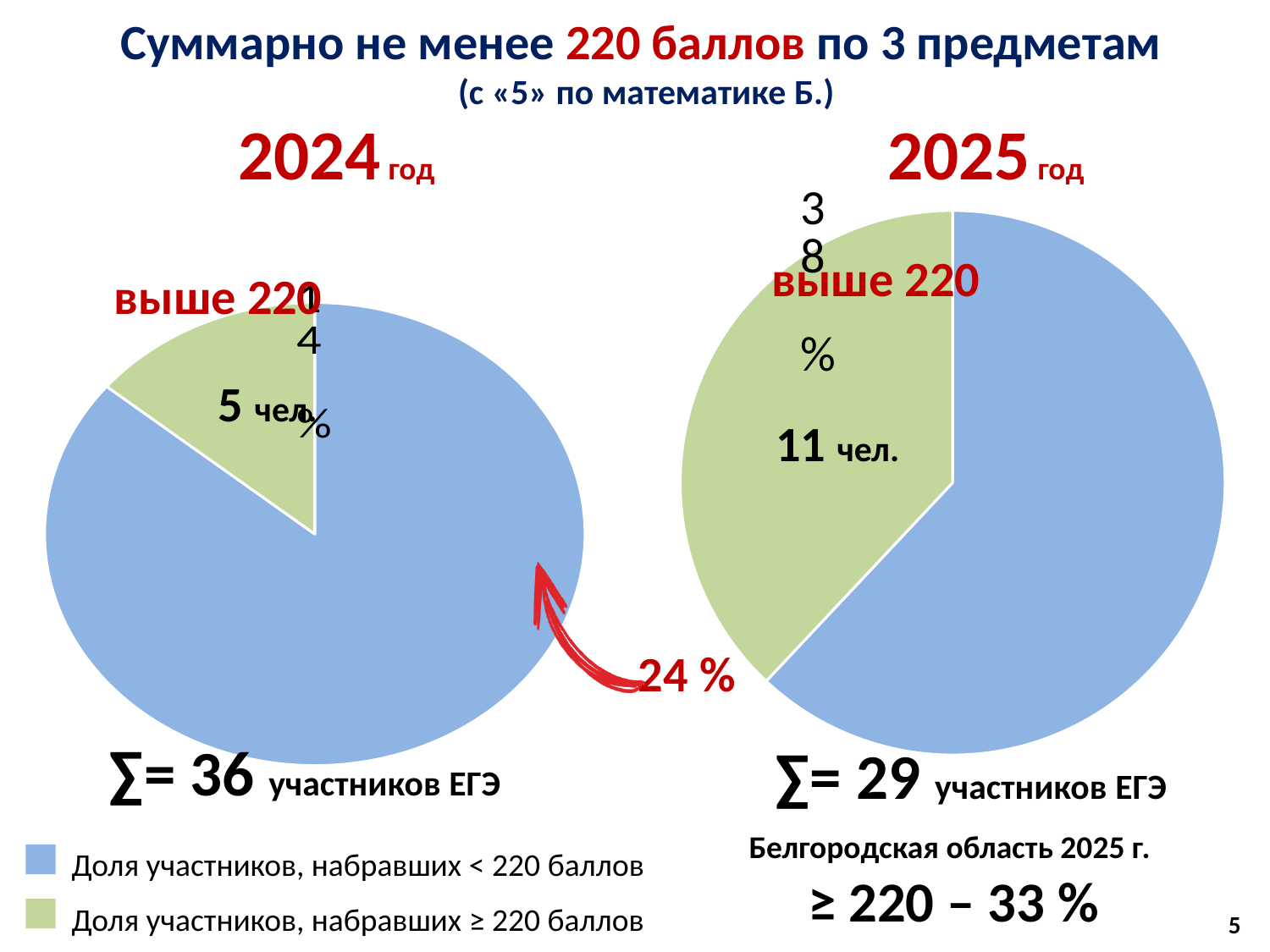
What share of participants scored ≥ 220 in Белгородская область in 2025 according to the slide? 33 % What kind of charts are shown on the slide? pie charts In the 2024 год chart, how many people scored above 220 points? 5 чел. In the 2025 год chart, how many people scored above 220 points? 11 чел. In the 2025 год chart, what percentage of participants scored above 220 points? 38% How many categories does the legend list? 2 How many more people scored above 220 in 2025 than in 2024? 6 How many ЕГЭ participants in total are shown for the 2025 год chart? 29 Which year had more participants scoring above 220 points, 2024 or 2025? 2025 How many ЕГЭ participants in total are shown for the 2024 год chart? 36 Which colour represents the share of participants who scored ≥ 220 points? green In the 2025 год chart, which slice is larger: participants with < 220 points or participants with ≥ 220 points? < 220 баллов